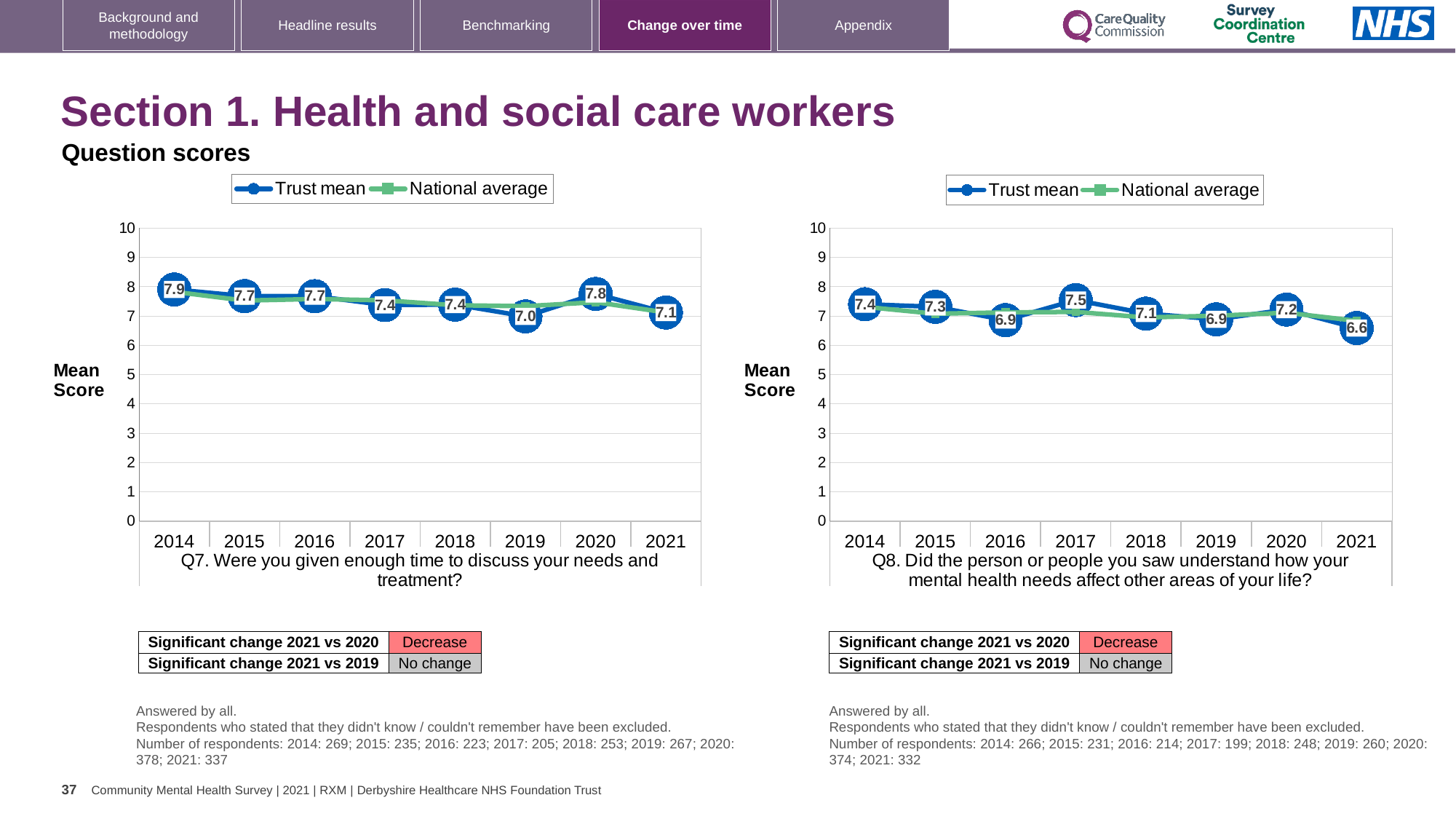
In the Q7 chart, which year has the highest Trust mean? 2014 In the Q8 chart, which year has the lowest Trust mean? 2021 In the Q8 chart, is the Trust mean higher in 2014 or in 2021? 2014 In the Q7 chart, which year has the lowest Trust mean? 2019 How many years are plotted on the x axis of the Q7 chart? 8 In the Q7 chart, what is the Trust mean for 2014? 7.9 In the Q8 chart, what is the Trust mean for 2017? 7.5 In the Q7 chart, what is the difference between the Trust mean in 2020 and in 2021? 0.7 How many series does the legend of the Q8 chart list? 2 In the Q8 chart, what is the Trust mean for 2021? 6.6 What type of chart is the Q7 chart? Line chart In the Q7 chart, what is the Trust mean for 2019? 7.0